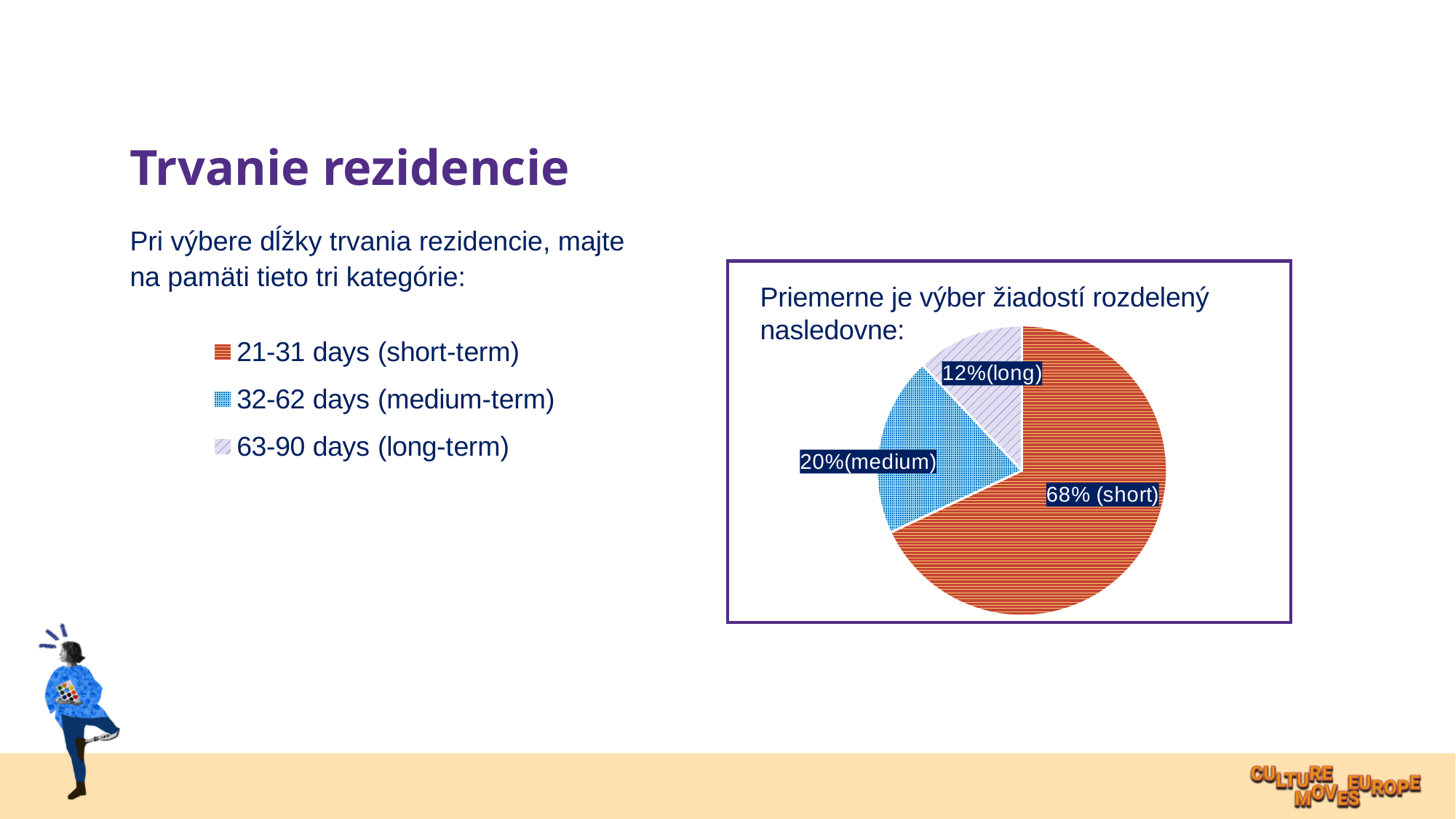
What share of the pie is labelled long? 12% Which duration category does the short slice correspond to in the legend? 21-31 days (short-term) What share of the pie is labelled medium? 20% Which slice of the pie is the largest? short How many slices does the pie chart have? 3 What is the difference in percentage points between the short and medium slices? 48 What share of the pie is labelled short? 68% Which duration category does the long slice correspond to in the legend? 63-90 days (long-term) What kind of chart is shown on the slide? pie chart What is the difference in percentage points between the medium and long slices? 8 Which is larger, the medium slice or the long slice? medium Which slice of the pie is the smallest? long